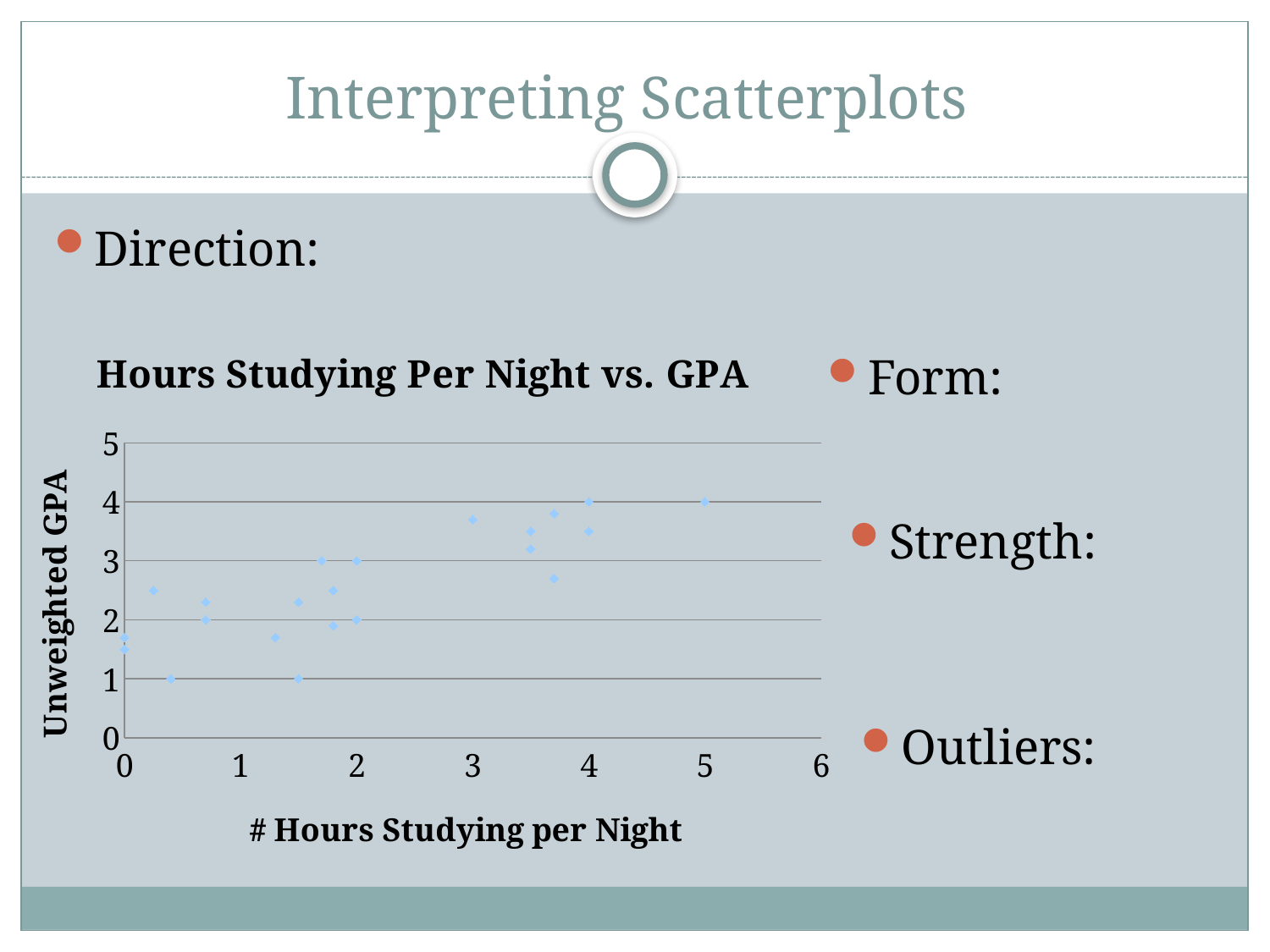
Is the GPA of the point at 0.4 hours studying per night greater or less than 2? less Is the GPA of the lowest point at 1.5 hours studying per night greater or less than 2? less Is the GPA of the point at 3 hours studying per night greater or less than 3? greater What is the highest value shown on the vertical axis of the chart? 5 What is the title of the chart? Hours Studying Per Night vs. GPA What is the highest value shown on the horizontal axis of the chart? 6 What kind of chart is shown on the slide? Scatter plot Which has the higher GPA: the point at 5 hours studying or the point at 0.4 hours studying? The point at 5 hours As the number of hours studying per night increases, does the unweighted GPA generally rise or fall? Rise